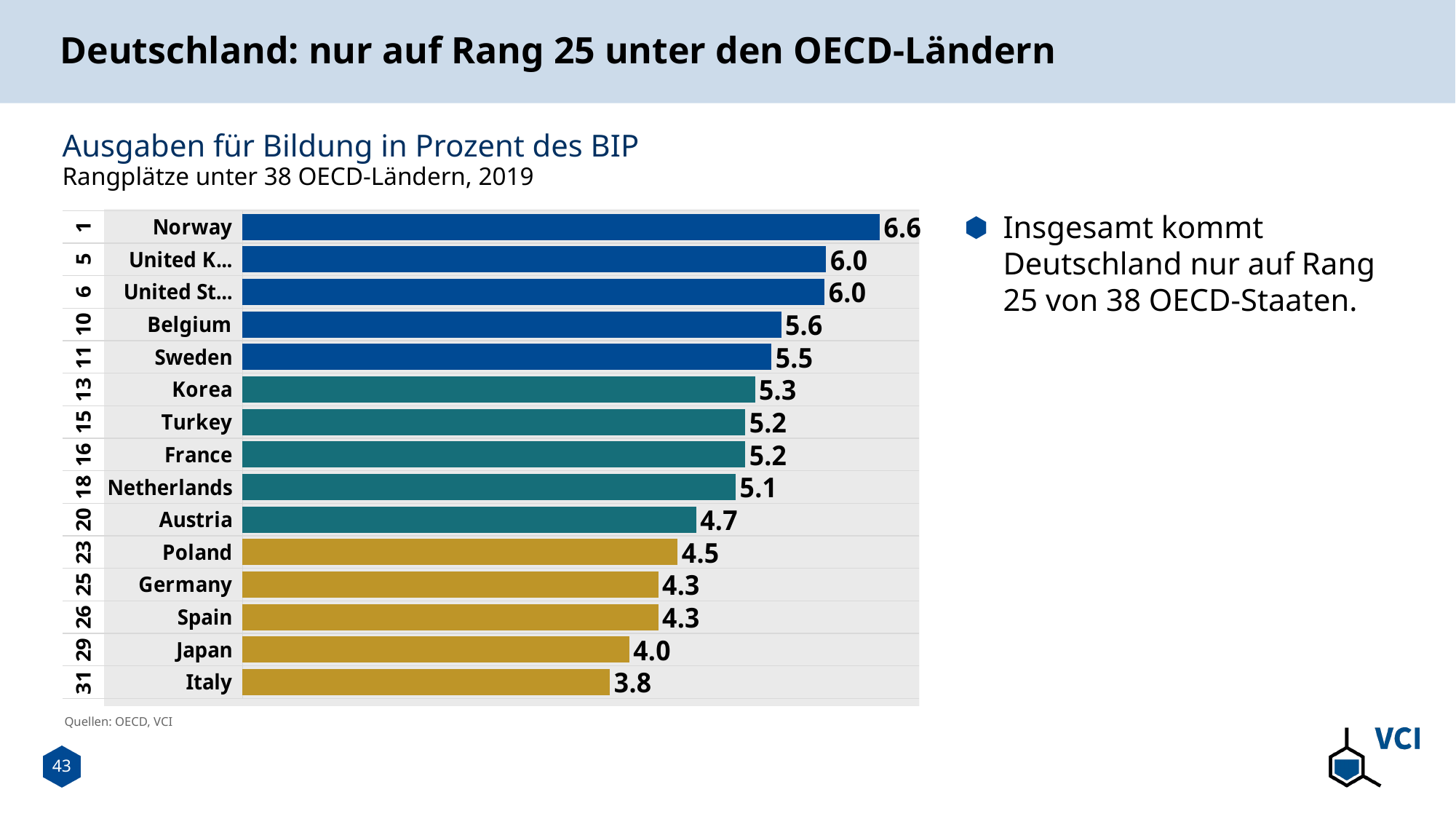
Which country has the lowest value? Italy How many countries are shown in the chart? 15 What kind of chart is shown on the slide? Bar chart Which has a larger value, Poland or Sweden? Sweden What is the difference between the values for Norway and Germany? 2.3 What rank is shown next to Germany? 25 What is the value for Norway? 6.6 Which has a larger value, Korea or Austria? Korea Which country has the highest value? Norway What is the value for Germany? 4.3 What is the value for Netherlands? 5.1 What is the difference between the values for Belgium and Japan? 1.6